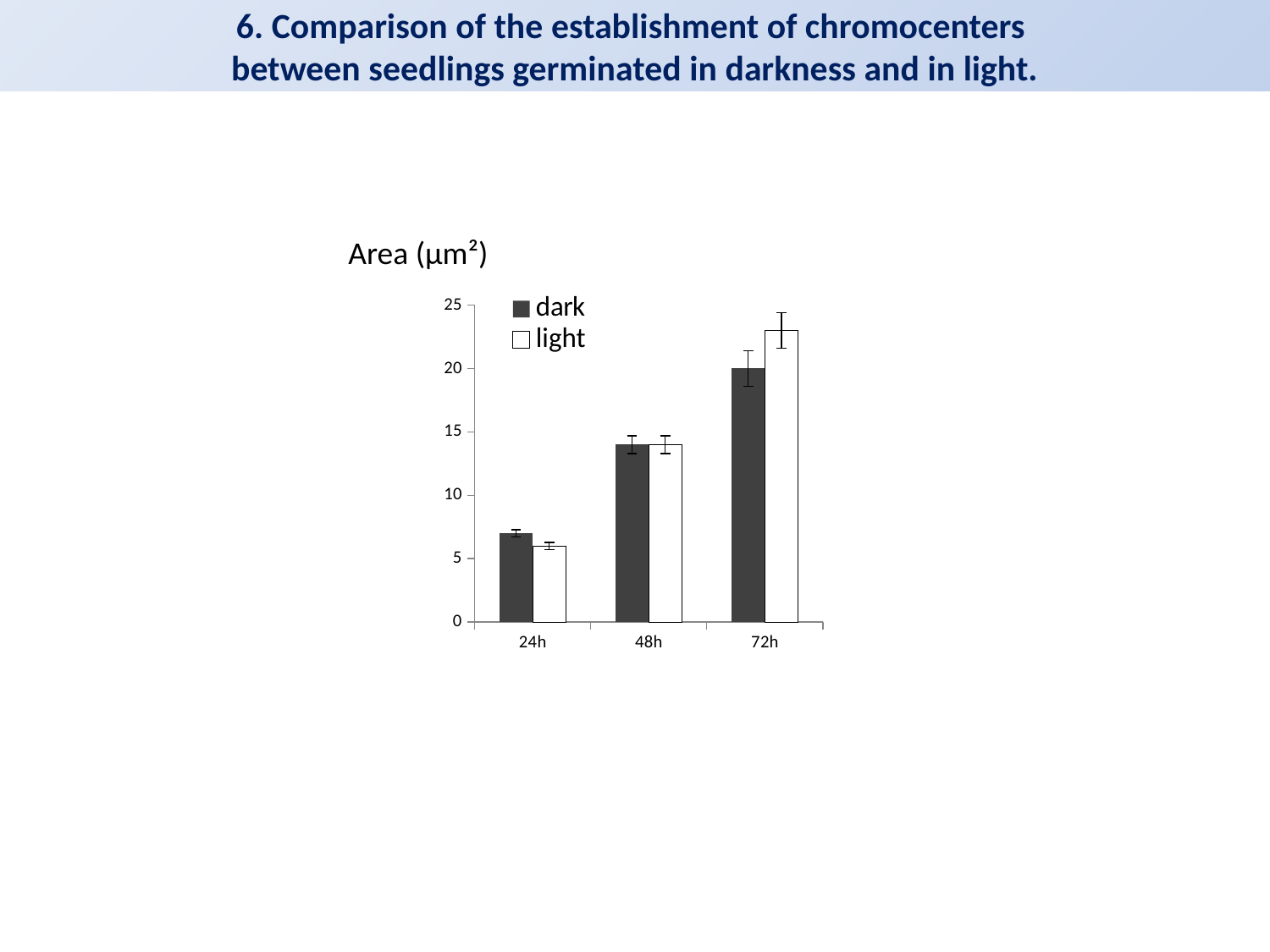
Which series and time point has the shortest bar? light at 24h Do the dark series values rise or fall from 24h to 72h? rise Is the value for light at 48h greater or less than 10? greater What is the label of the y axis? Area (µm²) Is the value for light at 72h greater or less than 20? greater Which series and time point has the tallest bar? light at 72h At 72h, which is larger, the dark bar or the light bar? light Is the value for dark at 72h greater or less than 15? greater At 24h, which is larger, the dark bar or the light bar? dark How many series does the legend list? 2 What kind of chart is shown on the slide? bar chart How many time-point categories are shown on the x axis? 3